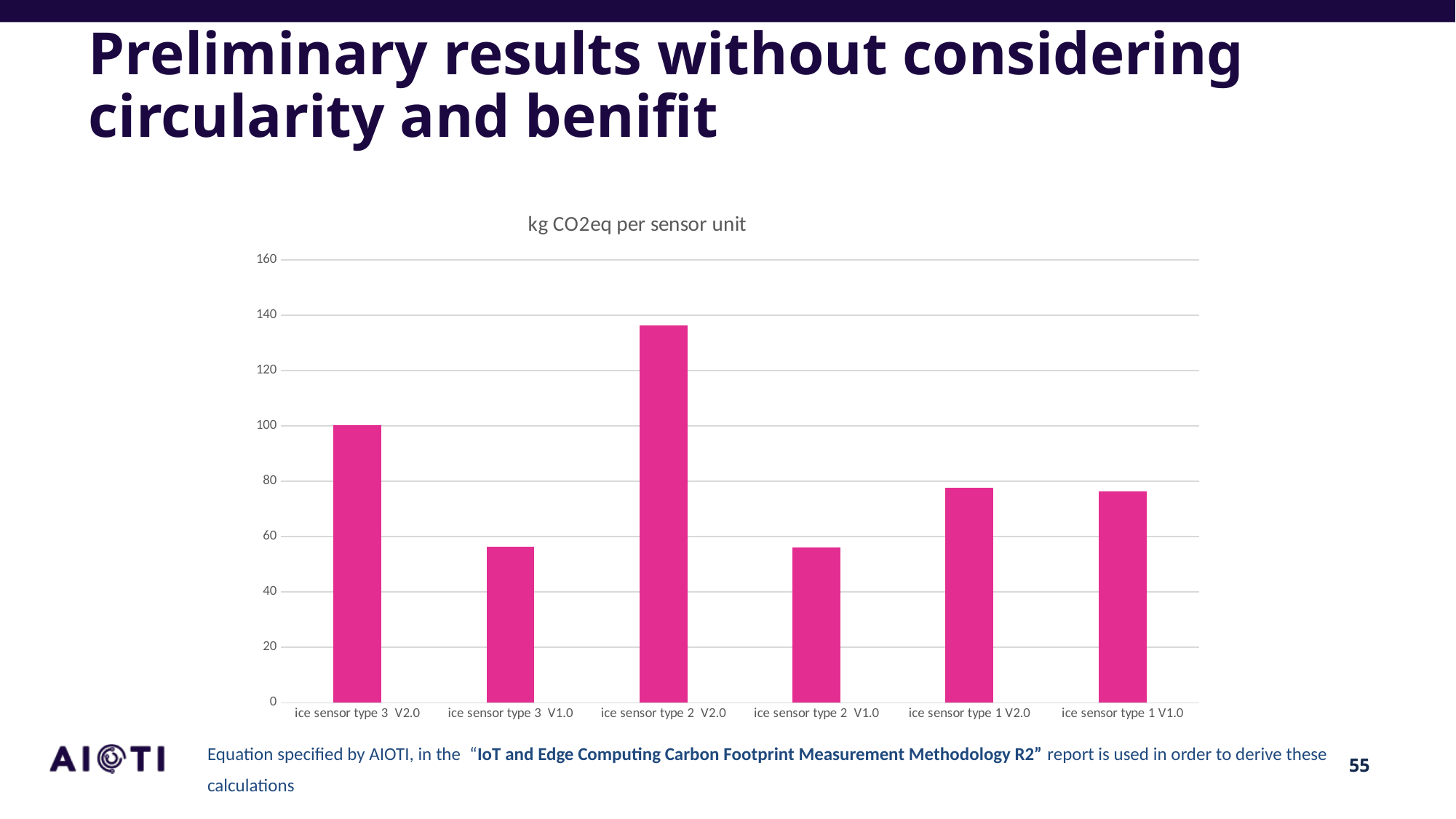
Is the value for ice sensor type 2 V1.0 greater or less than 60? less Which is larger, the value for ice sensor type 3 V2.0 or ice sensor type 3 V1.0? ice sensor type 3 V2.0 Is the value for ice sensor type 1 V1.0 greater or less than 60? greater Is the value for ice sensor type 2 V2.0 greater or less than 120? greater How many sensor categories are plotted in the chart? 6 Which is larger, the value for ice sensor type 2 V2.0 or ice sensor type 1 V2.0? ice sensor type 2 V2.0 What is the title of the chart? kg CO2eq per sensor unit What kind of chart is shown on the slide? Bar chart Which sensor category has the highest kg CO2eq per sensor unit? ice sensor type 2 V2.0